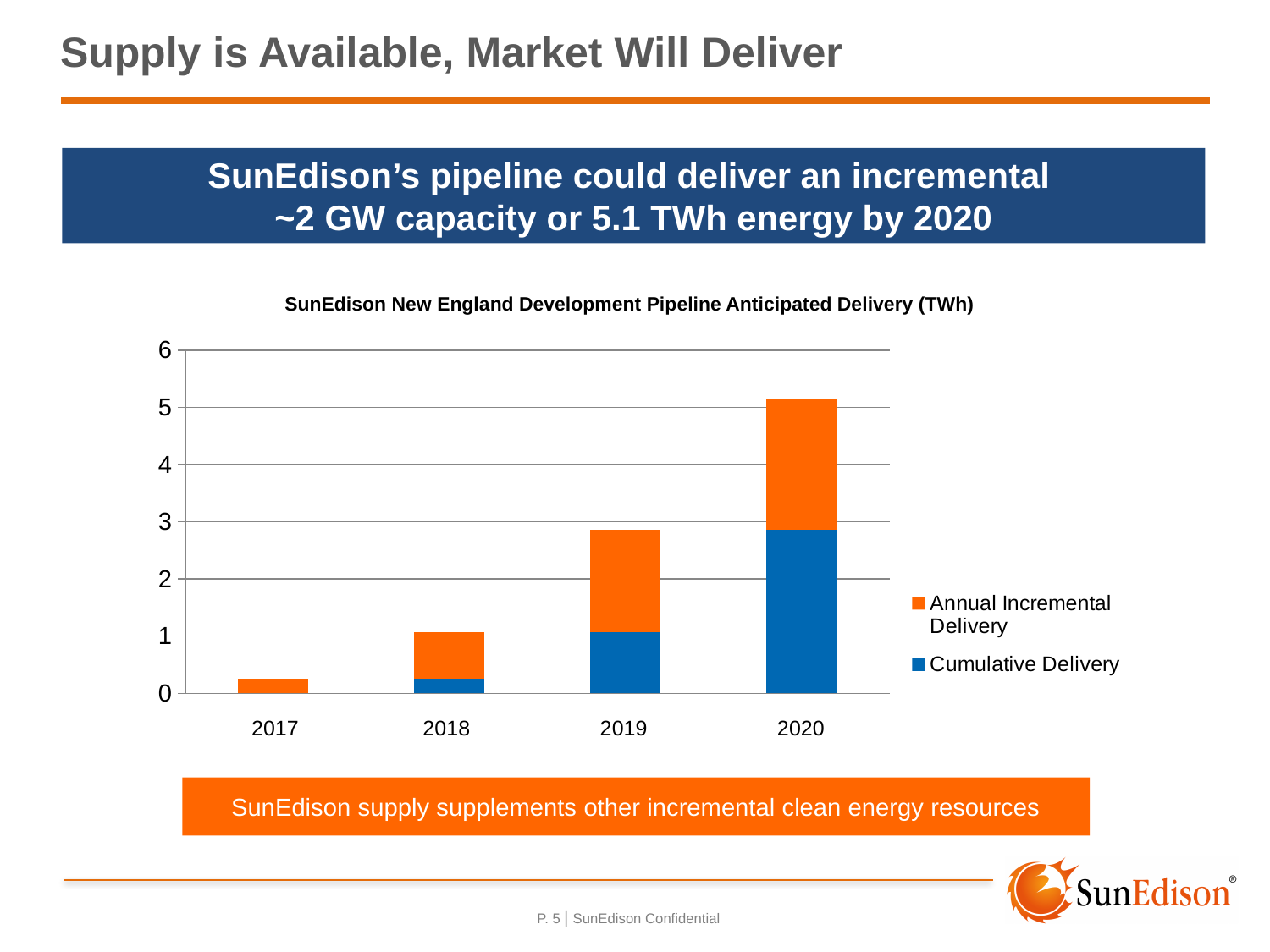
What kind of chart is shown on the slide? Stacked bar chart Is the total stacked bar for 2020 greater or less than 5? greater Do the total bar heights rise or fall from 2017 to 2020? Rise Is the total stacked bar for 2017 greater or less than 1? less Which series is shown in orange in the chart? Annual Incremental Delivery What is the title of the chart? SunEdison New England Development Pipeline Anticipated Delivery (TWh) Which year has the tallest stacked bar in the chart? 2020 How many years are shown on the x axis of the chart? 4 Is the total stacked bar for 2019 greater or less than 3? less How many series does the chart's legend list? 2 Which year has the shortest stacked bar in the chart? 2017